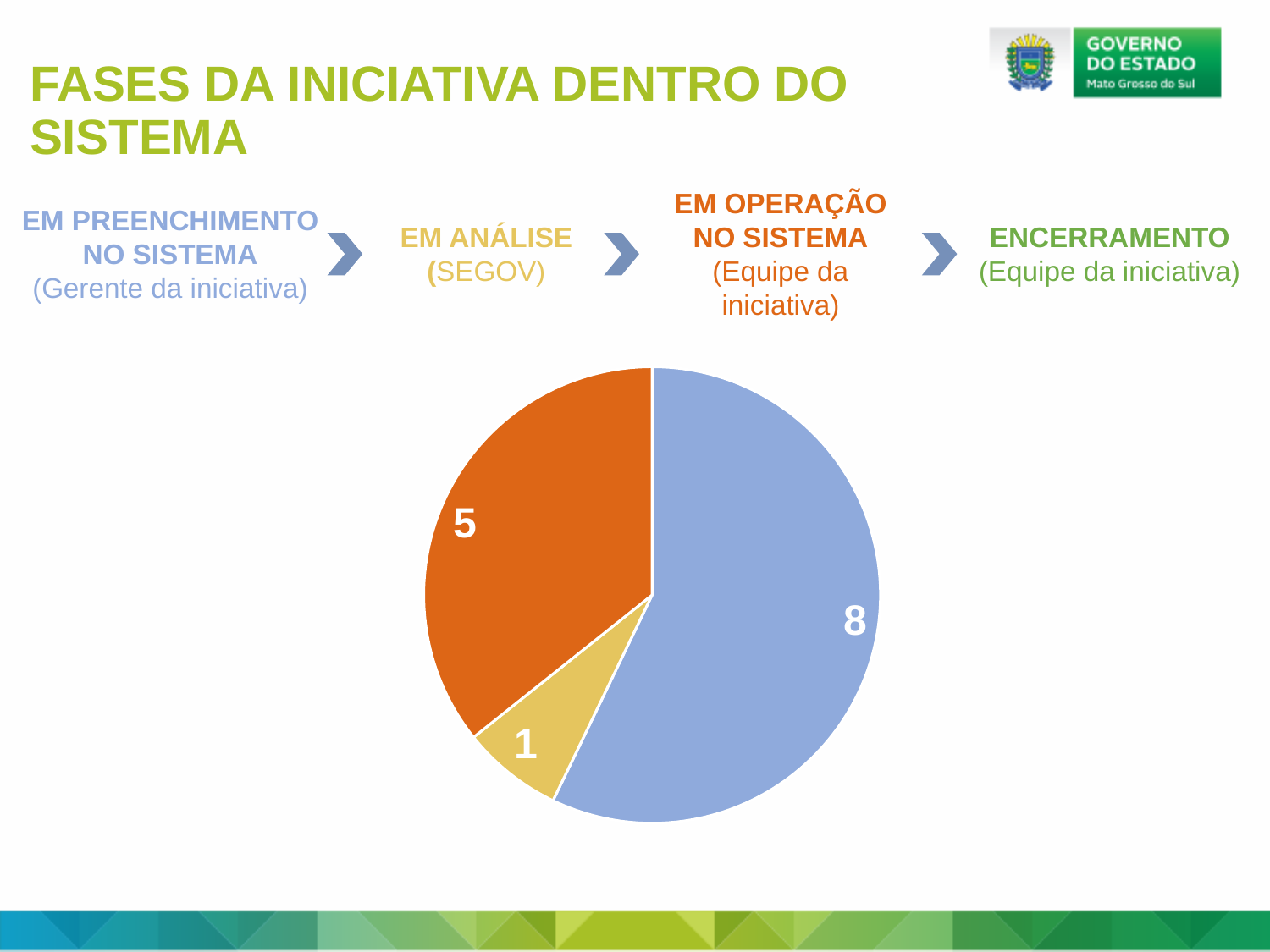
What is the value of the yellow slice of the pie chart? 1 How many slices does the pie chart have? 3 What is the difference between the blue slice and the orange slice in the pie chart? 3 What share of the pie chart total does the blue slice represent? 8 out of 14 What is the value of the orange slice of the pie chart? 5 What kind of chart is shown on the slide? pie chart Which slice of the pie chart has the highest value? the blue slice (8) What is the total of all the values shown in the pie chart? 14 What is the value of the blue slice of the pie chart? 8 Which phase colour from the flow above the chart (green, ENCERRAMENTO) does not appear as a slice in the pie chart? green (ENCERRAMENTO) Which slice of the pie chart has the lowest value? the yellow slice (1) Which is larger in the pie chart, the orange slice or the yellow slice? the orange slice